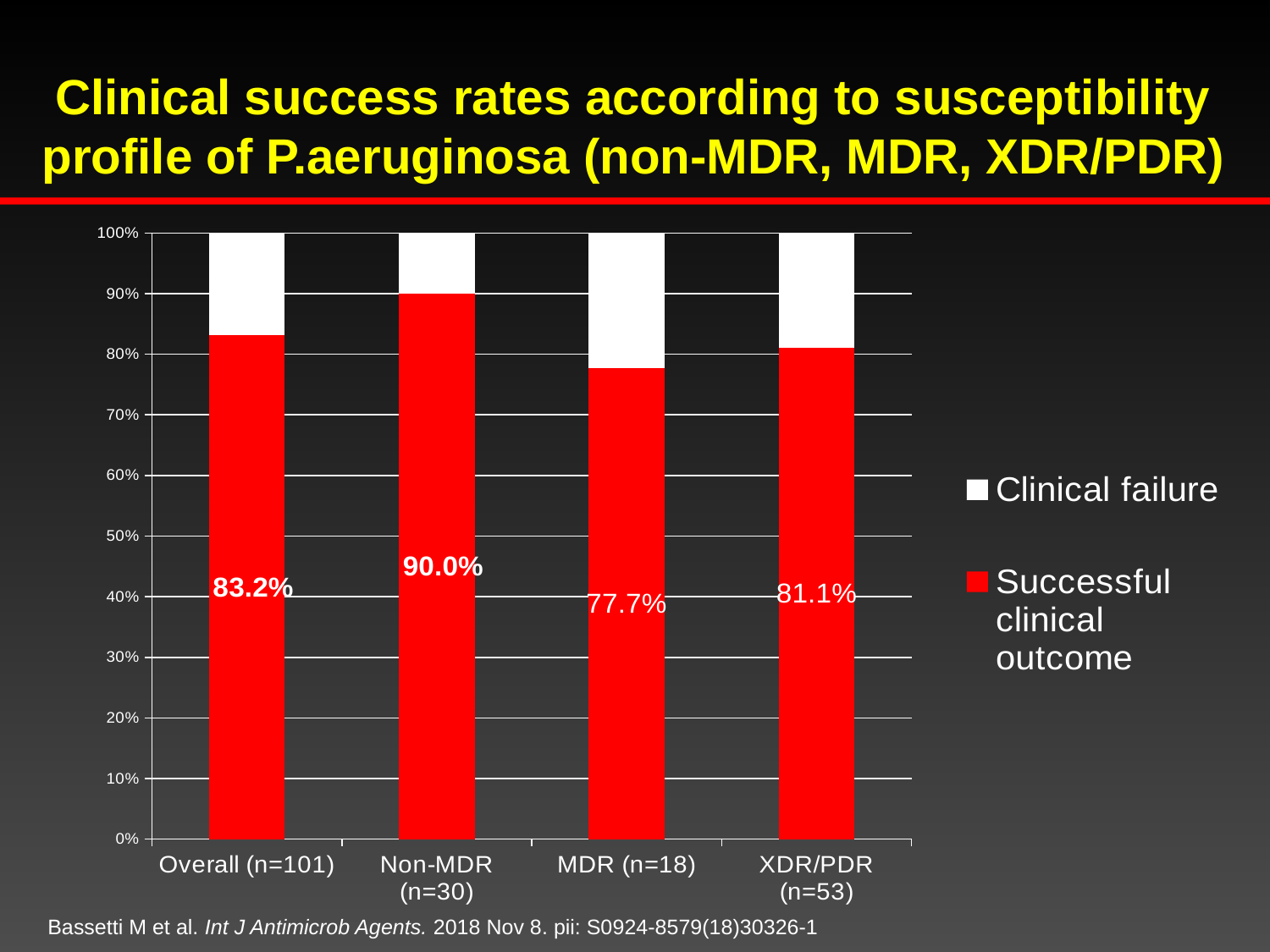
What is the successful clinical outcome rate for the XDR/PDR (n=53) group? 81.1% What kind of chart is shown on the slide? Stacked bar chart How many series does the chart legend list? 2 How many groups are shown on the x axis of the chart? 4 Is the successful clinical outcome rate for the Overall (n=101) group greater or less than 80%? greater Which has a higher successful clinical outcome rate, the XDR/PDR (n=53) group or the MDR (n=18) group? XDR/PDR (n=53) What is the successful clinical outcome rate for the Non-MDR (n=30) group? 90.0% What is the successful clinical outcome rate for the Overall (n=101) group? 83.2% Which group has the lowest successful clinical outcome rate? MDR (n=18) What is the difference in successful clinical outcome rate between the Non-MDR (n=30) and MDR (n=18) groups? 12.3% Which group has the highest successful clinical outcome rate? Non-MDR (n=30) What is the successful clinical outcome rate for the MDR (n=18) group? 77.7%